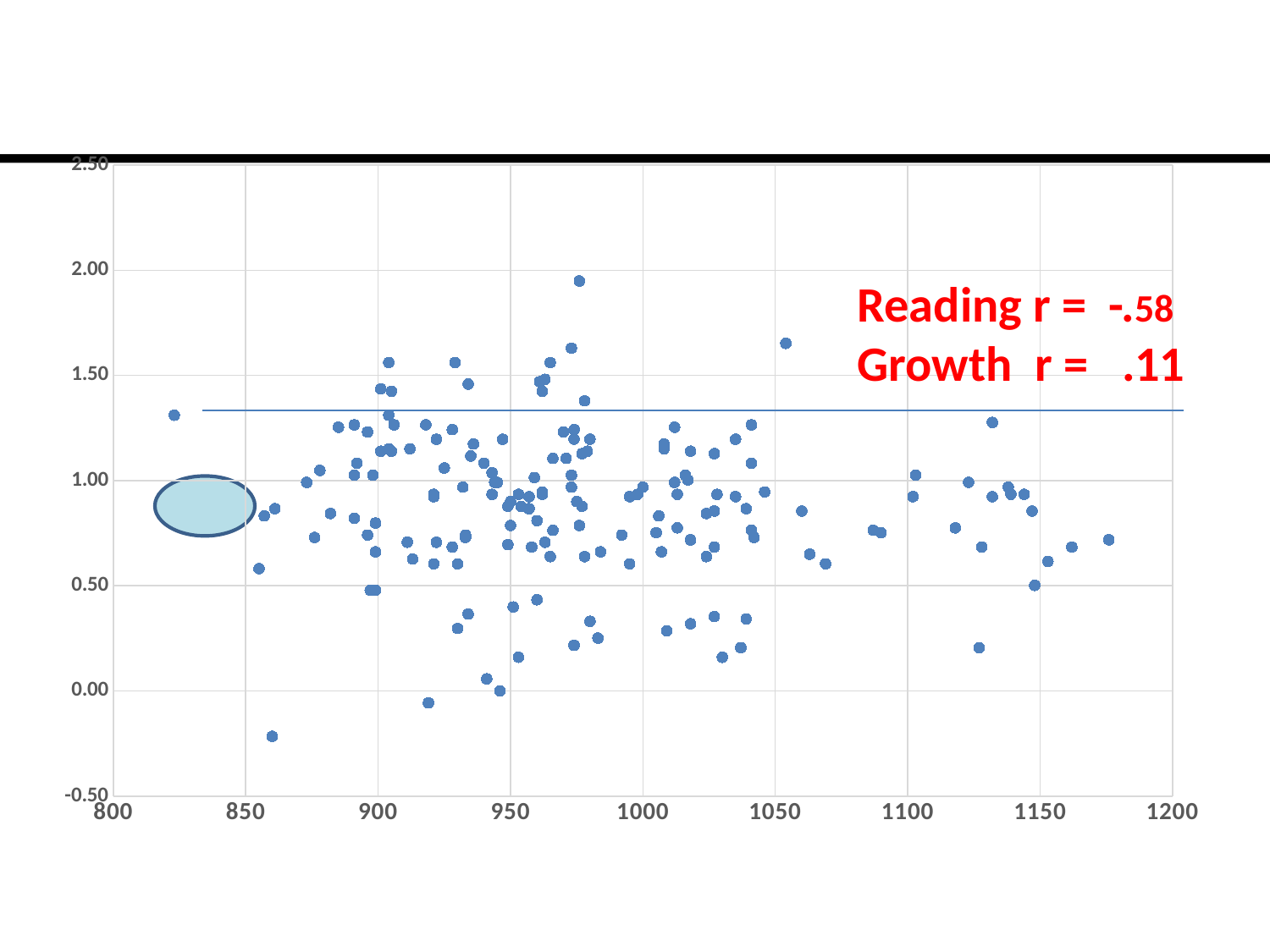
Is the y value of the highest plotted point greater or less than 1.50? greater Is the x value of the leftmost plotted point greater or less than 850? less Is the y value of the point plotted near x = 1050 at the top of the cluster greater or less than 1.50? greater What is the highest value shown on the vertical axis? 2.50 What kind of chart is shown on the slide? scatter chart What is the lowest value shown on the horizontal axis? 800